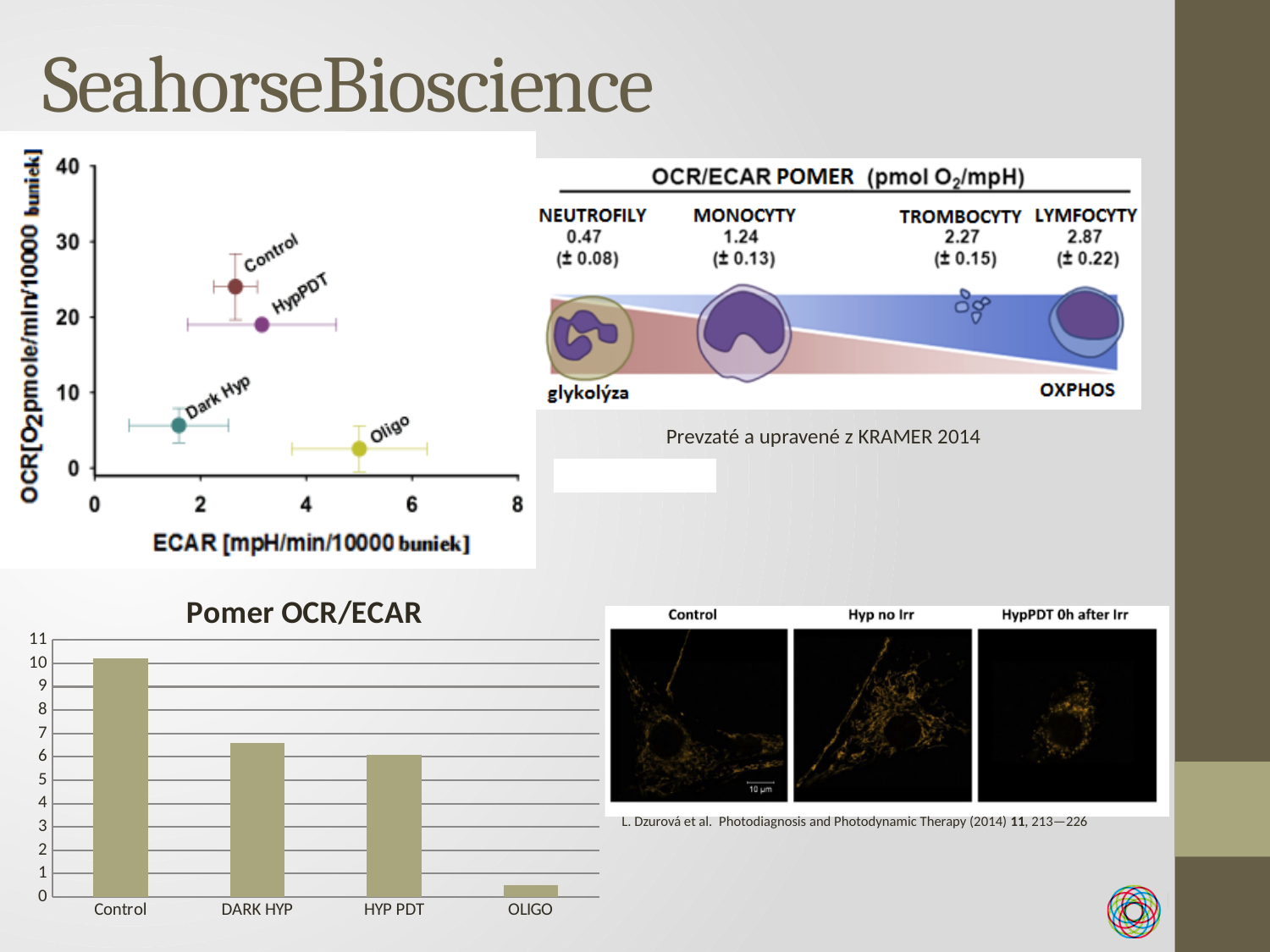
What kind of chart is the 'Pomer OCR/ECAR' chart at the bottom left of the slide? bar chart In the 'Pomer OCR/ECAR' bar chart, is the value for HYP PDT greater or less than 7? less In the 'Pomer OCR/ECAR' bar chart, how many categories are shown on the x axis? 4 In the scatter plot at the top left (OCR vs ECAR), is the ECAR value for Oligo greater or less than 4? greater In the 'Pomer OCR/ECAR' bar chart, which is larger, the value for Control or the value for HYP PDT? Control In the 'Pomer OCR/ECAR' bar chart, is the value for Control greater or less than 9? greater In the 'Pomer OCR/ECAR' bar chart, which category has the lowest value? OLIGO In the 'OCR/ECAR POMER' figure at the top right, what is the value given for LYMFOCYTY? 2.87 In the 'Pomer OCR/ECAR' bar chart, do the values rise or fall from left to right along the x axis? fall In the 'Pomer OCR/ECAR' bar chart, which category has the highest value? Control